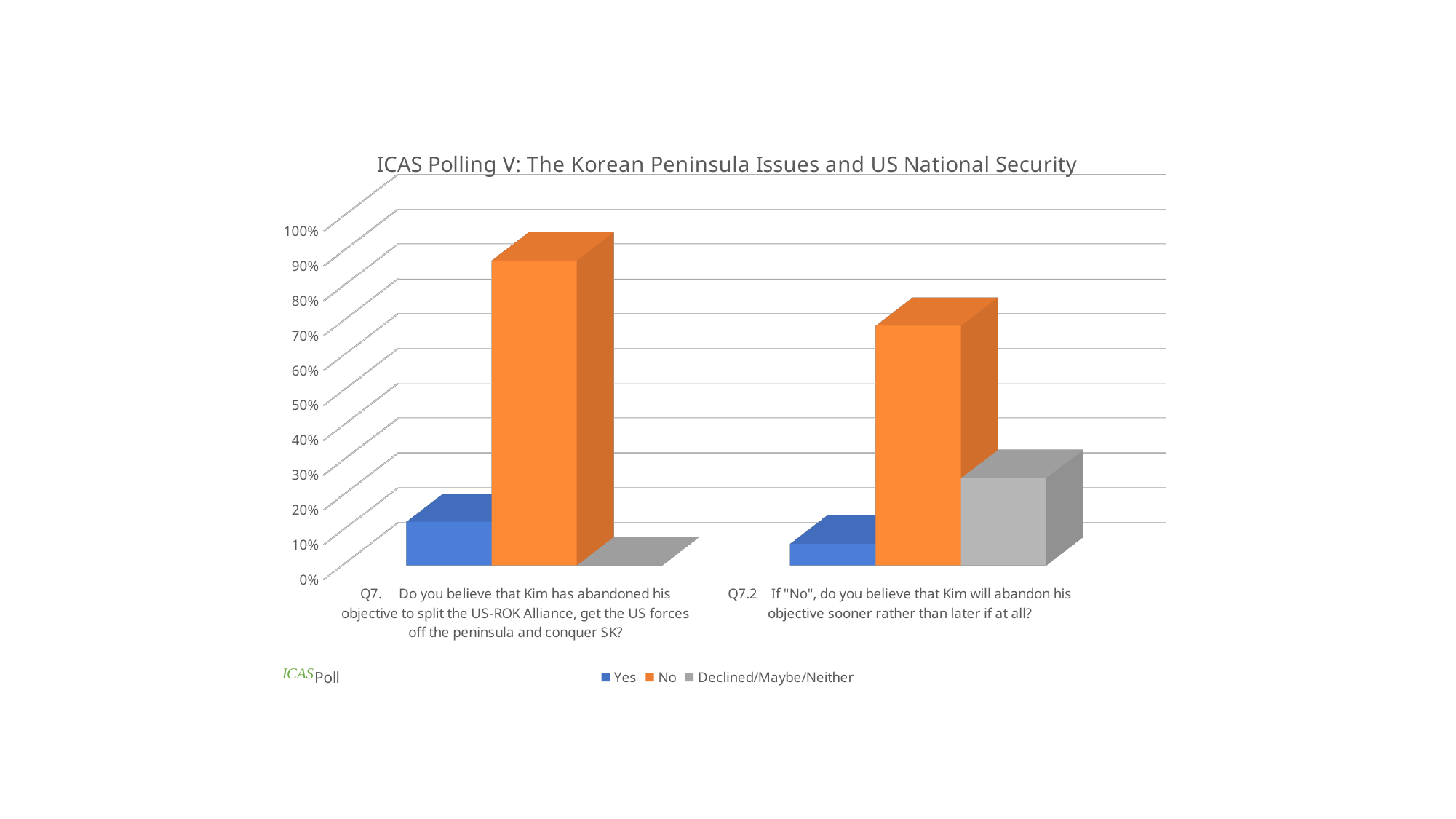
Which is larger: the "No" value for Q7 or the "No" value for Q7.2? Q7 How many question categories are plotted on the x axis? 2 What kind of chart is shown on the slide? bar chart Which is larger: the "Declined/Maybe/Neither" value for Q7 or for Q7.2? Q7.2 What is the title of the chart? ICAS Polling V: The Korean Peninsula Issues and US National Security Which response series has the highest value for Q7? No Is the value for "Declined/Maybe/Neither" on Q7.2 greater or less than 10%? greater Is the value for "No" on Q7.2 greater or less than 60%? greater Is the value for "No" on Q7 greater or less than 80%? greater How many series does the legend list? 3 Which response series has the lowest value for Q7.2? Yes